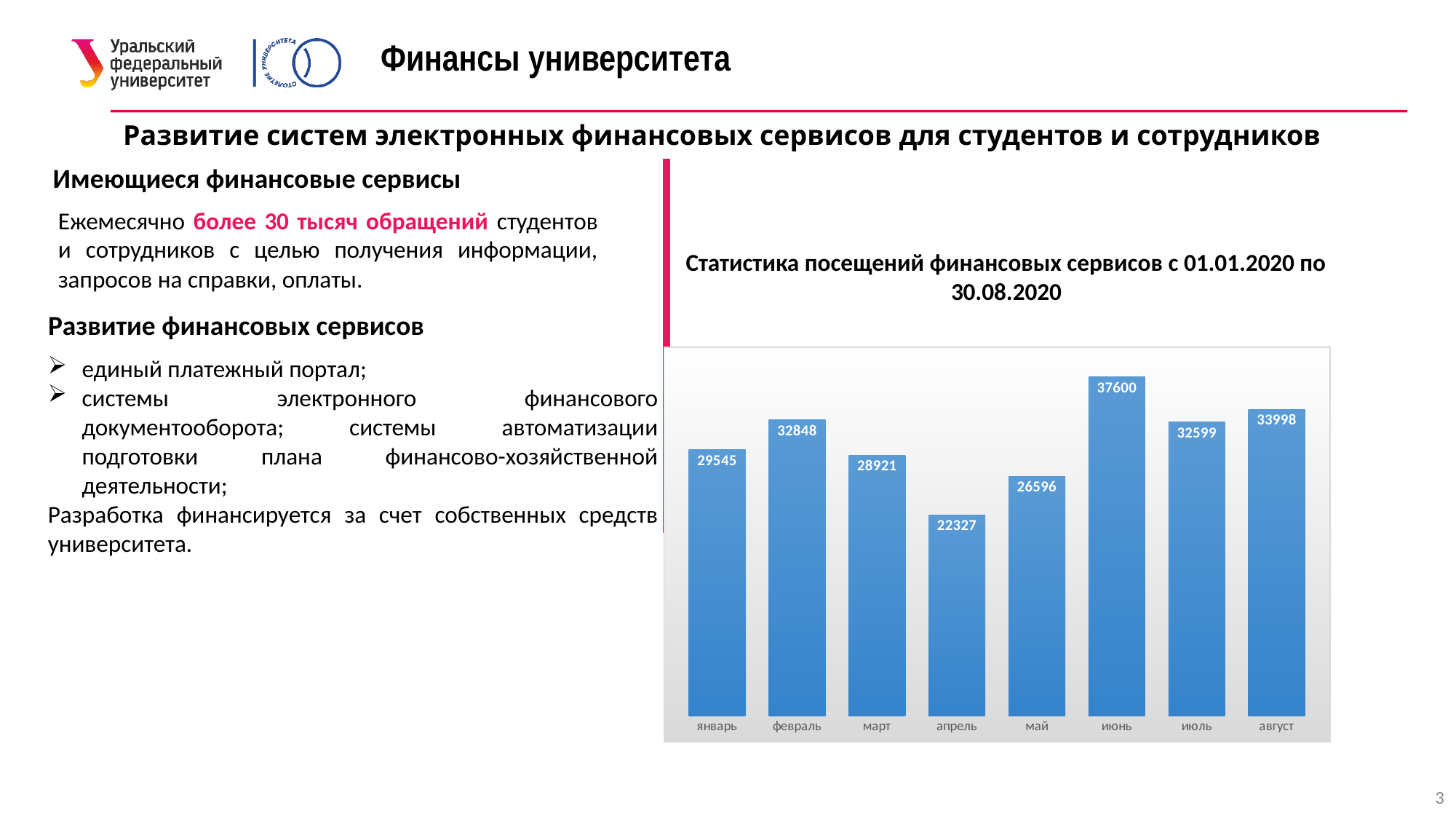
What is the value for январь in the chart? 29545 What is the value for июнь in the chart? 37600 What is the difference between the values for июнь and апрель? 15273 What is the title of the chart? Статистика посещений финансовых сервисов с 01.01.2020 по 30.08.2020 What kind of chart is shown on the slide? bar chart Which is larger, the value for август or the value for июль? август Which is larger, the value for март or the value for май? март What is the value for апрель in the chart? 22327 How many months are shown in the chart? 8 Which month has the lowest value in the chart? апрель Which month has the highest value in the chart? июнь What is the difference between the values for февраль and январь? 3303